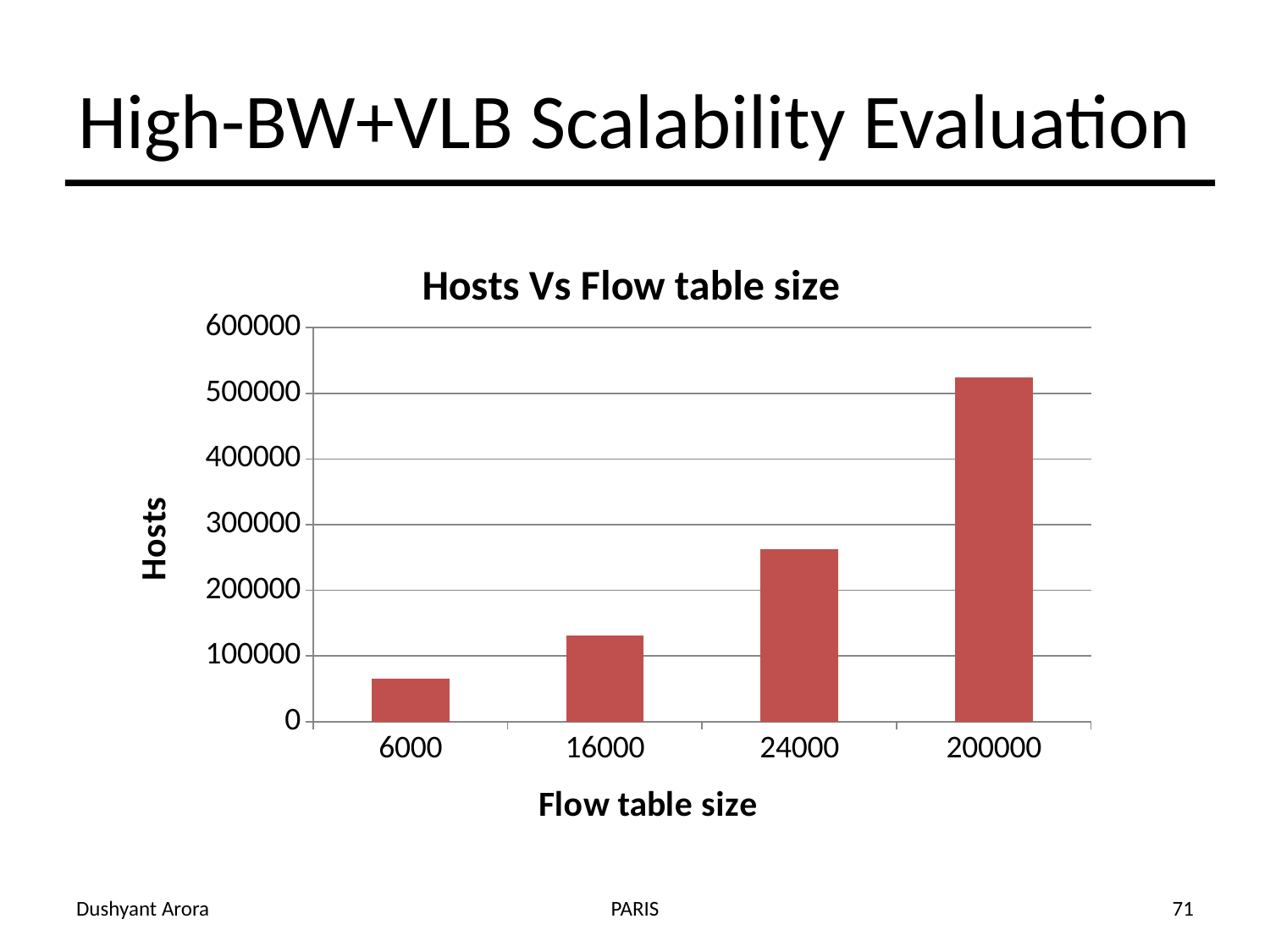
Is the value for flow table size 16000 greater or less than 100000? greater Which flow table size has the lowest number of hosts? 6000 Is the value for flow table size 6000 greater or less than 100000? less What is the title of the chart? Hosts Vs Flow table size Which flow table size has the highest number of hosts? 200000 Do the number of hosts rise or fall as flow table size increases along the x axis? rise How many flow table size categories are plotted on the x axis? 4 Which has more hosts, flow table size 16000 or flow table size 24000? 24000 Is the value for flow table size 200000 greater or less than 400000? greater What kind of chart is shown on the slide? bar chart What is the label of the y axis? Hosts